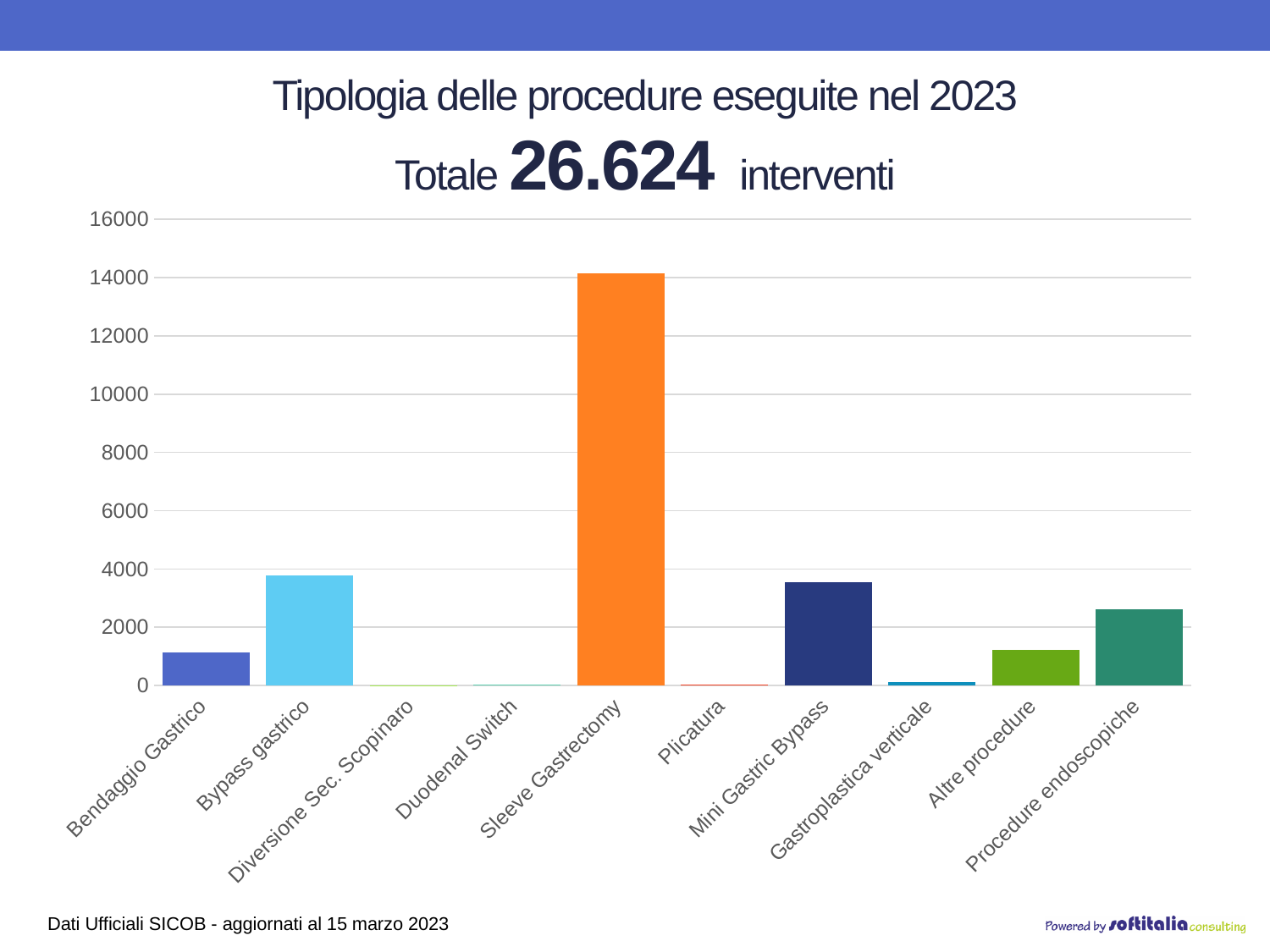
Is the value for Procedure endoscopiche greater or less than 2000? greater Is the value for Sleeve Gastrectomy greater or less than 16000? less Which is larger, the value for Procedure endoscopiche or the value for Altre procedure? Procedure endoscopiche What kind of chart is shown on the slide? bar chart Is the value for Mini Gastric Bypass greater or less than 2000? greater What total number of interventions is stated in the chart title? 26.624 Which procedure has the highest bar? Sleeve Gastrectomy Which is larger, the value for Sleeve Gastrectomy or the value for Bypass gastrico? Sleeve Gastrectomy How many procedure categories are shown on the x axis? 10